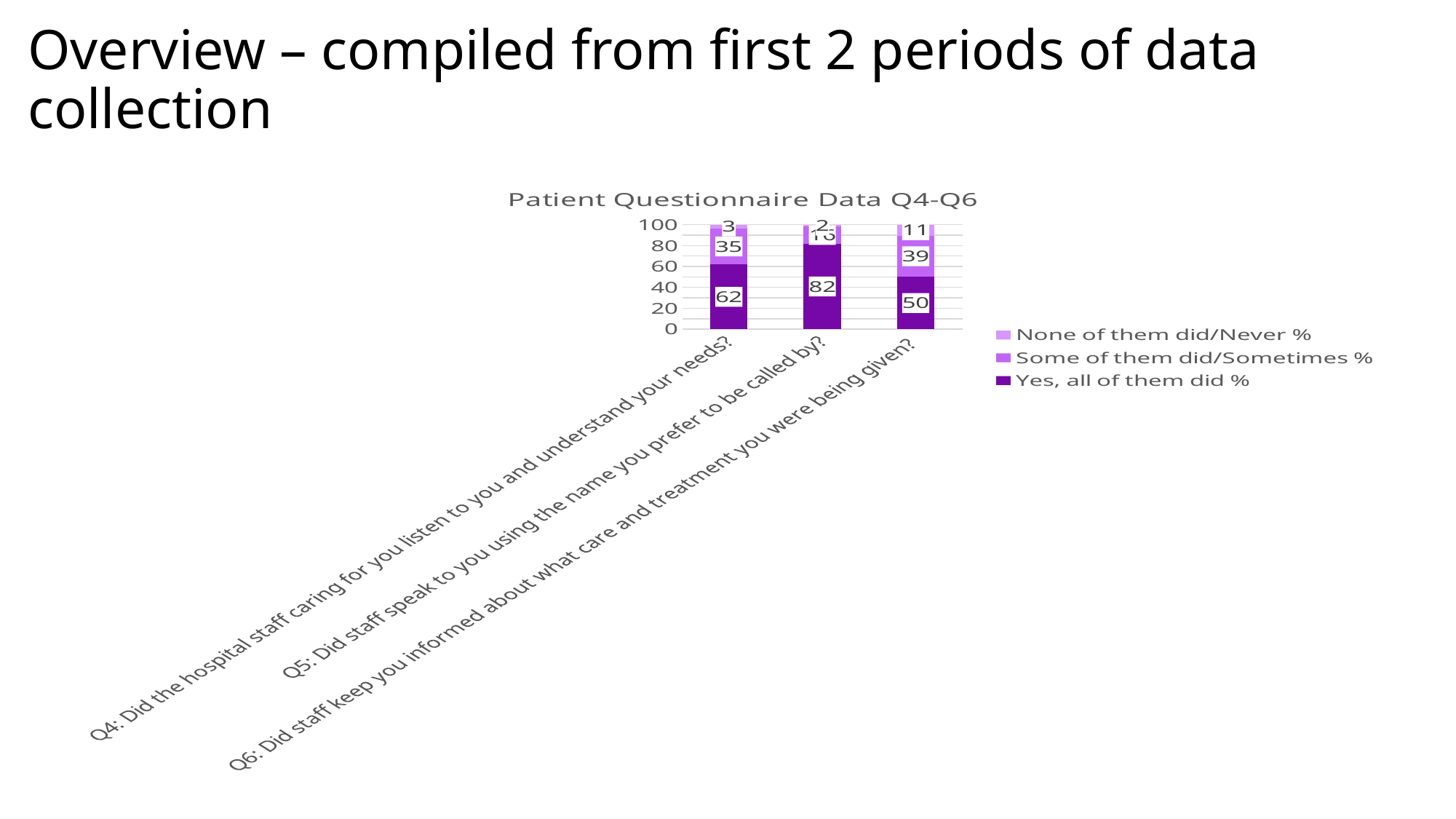
What is the 'Some of them did/Sometimes %' value for Q6? 39 What is the 'None of them did/Never %' value for Q6? 11 How many question categories are plotted on the x axis? 3 What type of chart is shown on the slide? Stacked bar chart What is the title of the chart? Patient Questionnaire Data Q4-Q6 What is the difference between the 'Yes, all of them did %' values for Q5 and Q6? 32 What is the 'Yes, all of them did %' value for Q5? 82 Which question has the highest 'Yes, all of them did %' value? Q5 How many series does the legend list? 3 Is the 'None of them did/Never %' value for Q6 larger than that for Q4? Yes Which question has the lowest 'Yes, all of them did %' value? Q6 What is the 'Yes, all of them did %' value for Q4? 62